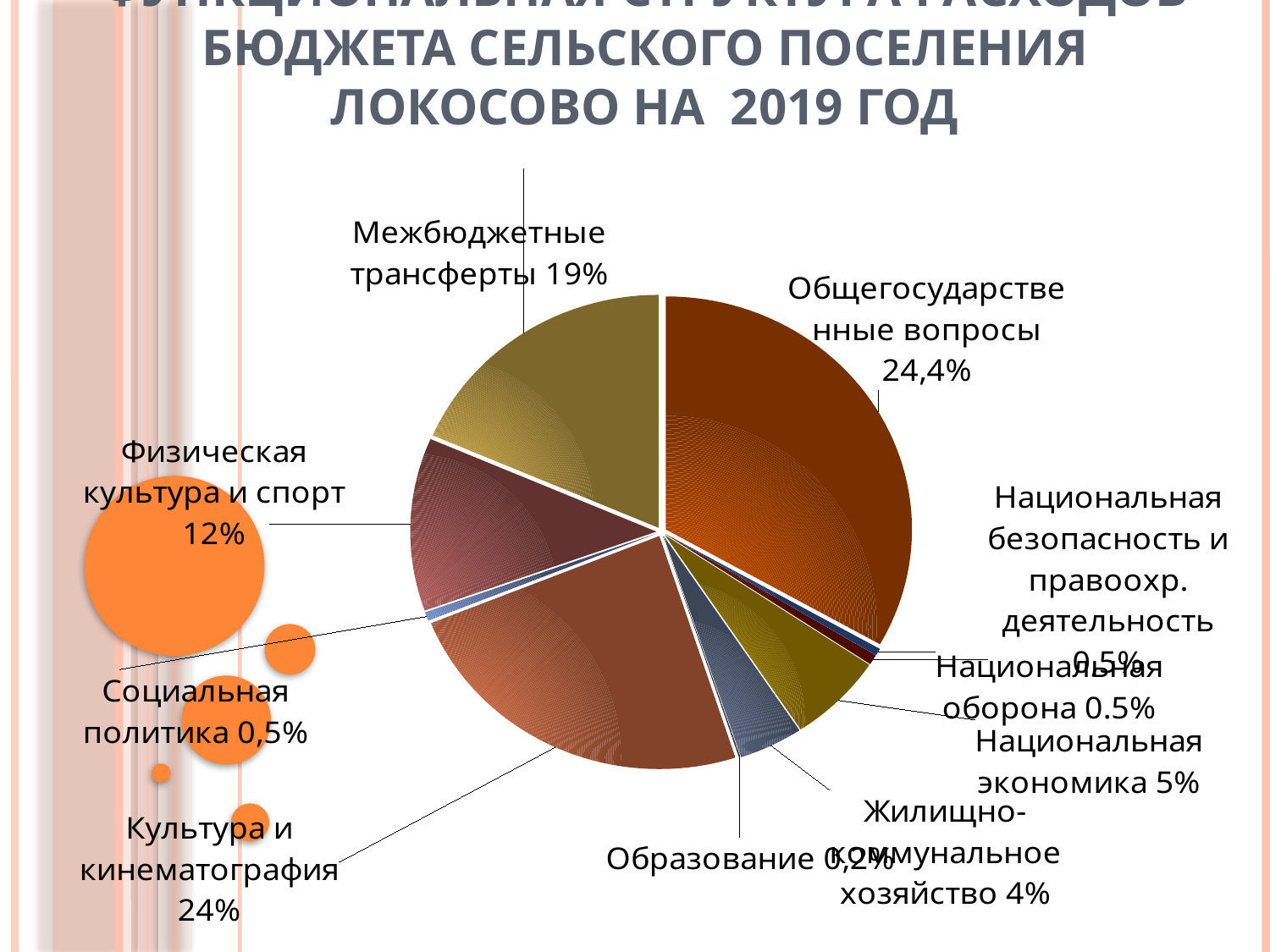
Which category has the largest share of the pie? Общегосударственные вопросы What is the value for Жилищно-коммунальное хозяйство? 4% How many categories are shown in the pie chart? 10 Which is larger, the share for Культура и кинематография or the share for Межбюджетные трансферты? Культура и кинематография What percentage is shown for Физическая культура и спорт? 12% Which category has the smallest share of the pie? Образование What is the value shown for Образование? 0,2% What is the value shown for Общегосударственные вопросы? 24,4% What kind of chart is shown on the slide? pie chart What share of the budget expenditure goes to Межбюджетные трансферты? 19% What share is shown for Национальная экономика? 5% What is the difference between the shares for Национальная экономика and Жилищно-коммунальное хозяйство? 1%